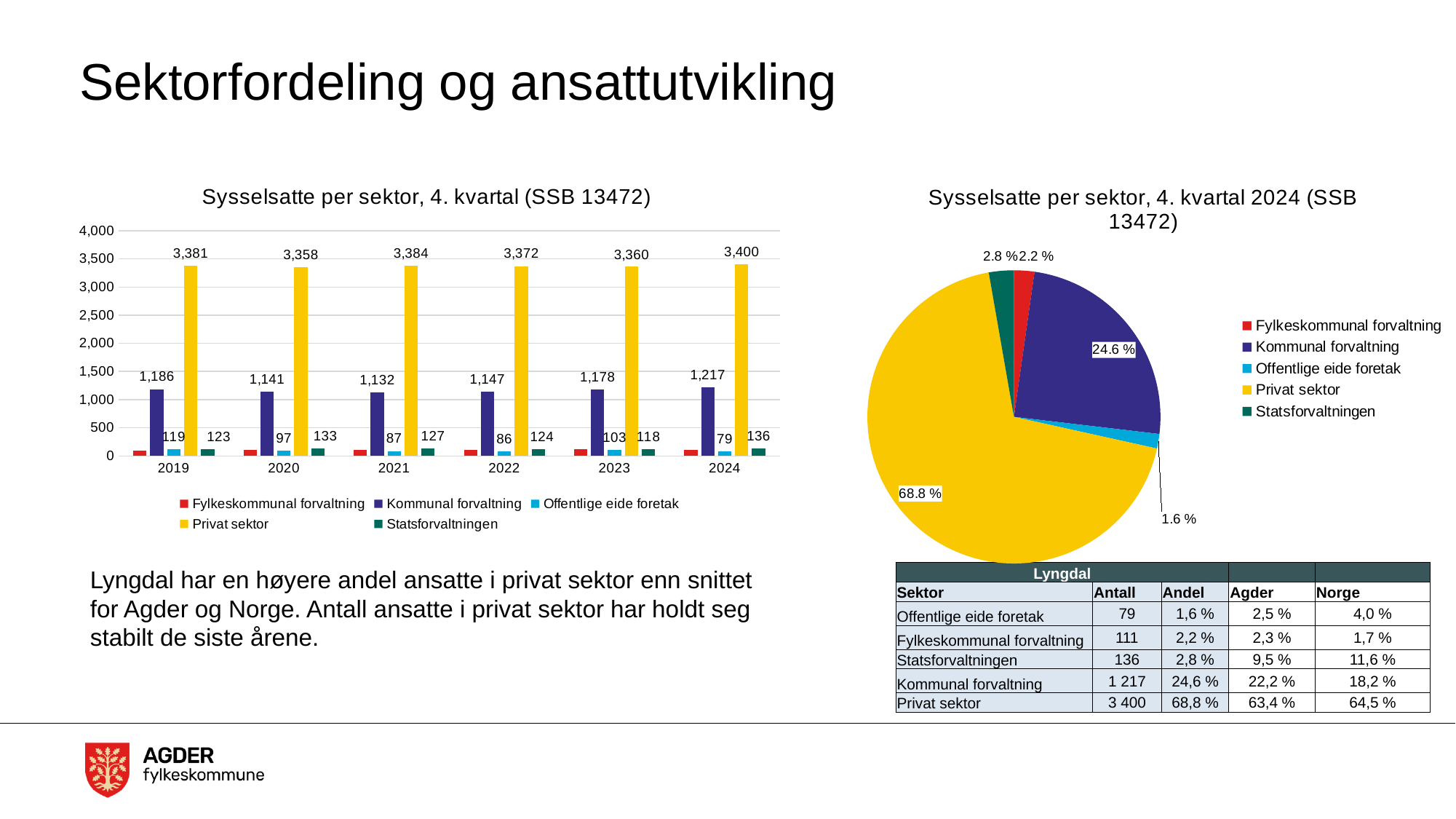
In the pie chart 'Sysselsatte per sektor, 4. kvartal 2024 (SSB 13472)', which sector has the smallest slice? Offentlige eide foretak In the bar chart 'Sysselsatte per sektor, 4. kvartal (SSB 13472)', in which year is the Privat sektor value highest? 2024 What kind of chart is the left chart titled 'Sysselsatte per sektor, 4. kvartal (SSB 13472)'? bar chart In the bar chart 'Sysselsatte per sektor, 4. kvartal (SSB 13472)', what is the value for Kommunal forvaltning in 2021? 1,132 In the bar chart 'Sysselsatte per sektor, 4. kvartal (SSB 13472)', in which year is the Offentlige eide foretak value lowest? 2024 In the bar chart 'Sysselsatte per sektor, 4. kvartal (SSB 13472)', what is the value for Privat sektor in 2024? 3,400 In the pie chart 'Sysselsatte per sektor, 4. kvartal 2024 (SSB 13472)', what share does Privat sektor have? 68.8 % How many years are shown on the x axis of the bar chart 'Sysselsatte per sektor, 4. kvartal (SSB 13472)'? 6 In the bar chart 'Sysselsatte per sektor, 4. kvartal (SSB 13472)', is the value for Fylkeskommunal forvaltning in 2024 greater or less than 500? less How many series does the legend of the bar chart 'Sysselsatte per sektor, 4. kvartal (SSB 13472)' list? 5 In the bar chart 'Sysselsatte per sektor, 4. kvartal (SSB 13472)', is the Statsforvaltningen value larger in 2020 or in 2023? 2020 In the bar chart 'Sysselsatte per sektor, 4. kvartal (SSB 13472)', what is the difference between the Privat sektor values for 2024 and 2019? 19